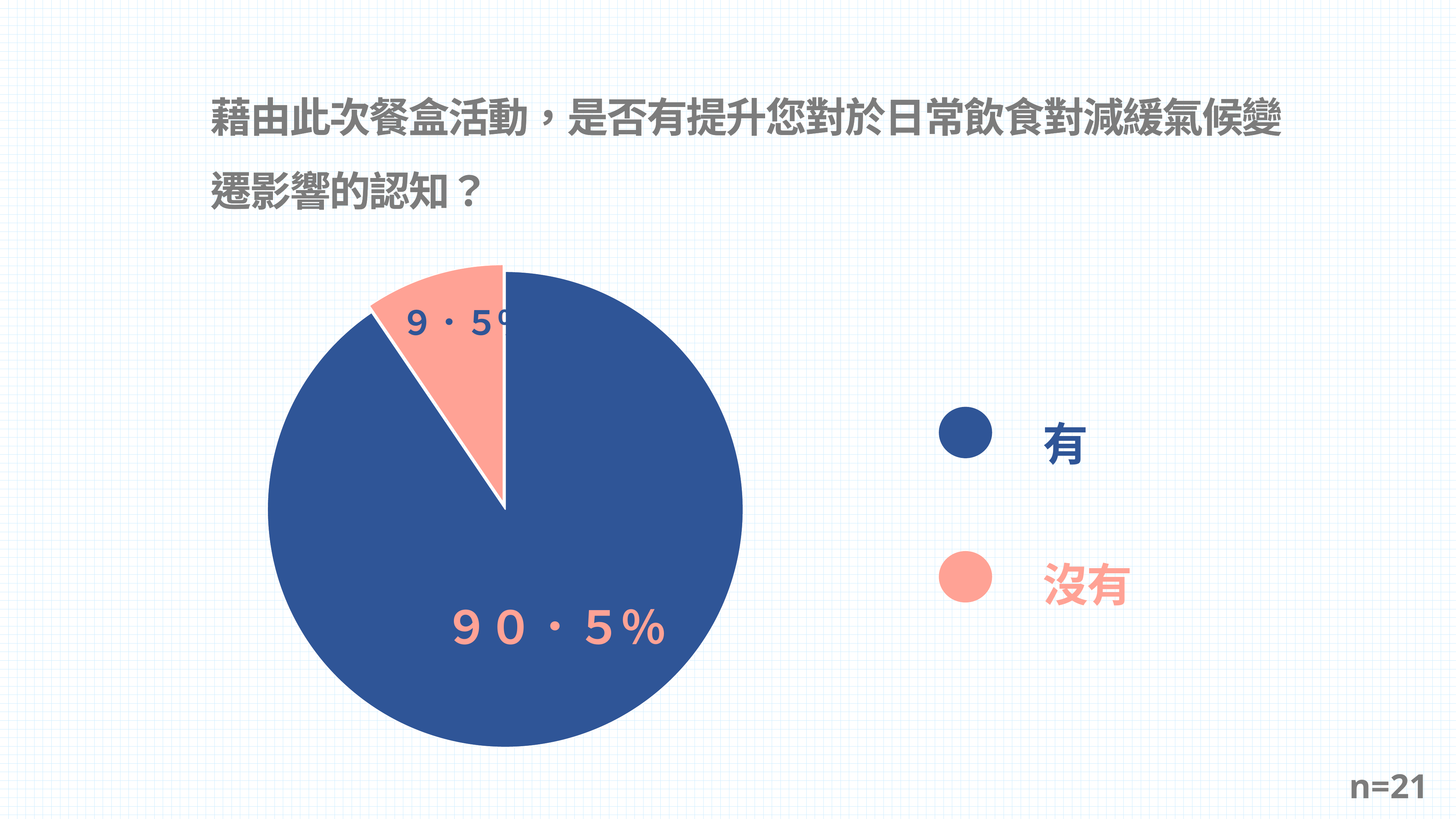
What sample size (n) is shown on the slide? n=21 How many entries does the legend list? 2 Which category has the largest slice of the pie? 有 Which category has the smallest slice of the pie? 沒有 What is the difference in percentage points between the 有 slice and the 沒有 slice? 81% What percentage of respondents answered 有? 90.5% What colour is the slice for 有? blue Which is larger, the share for 有 or the share for 沒有? 有 How many slices does the pie chart have? 2 What percentage of respondents answered 沒有? 9.5% What share of the pie does the 有 slice represent? 90.5% What kind of chart is shown on the slide? pie chart